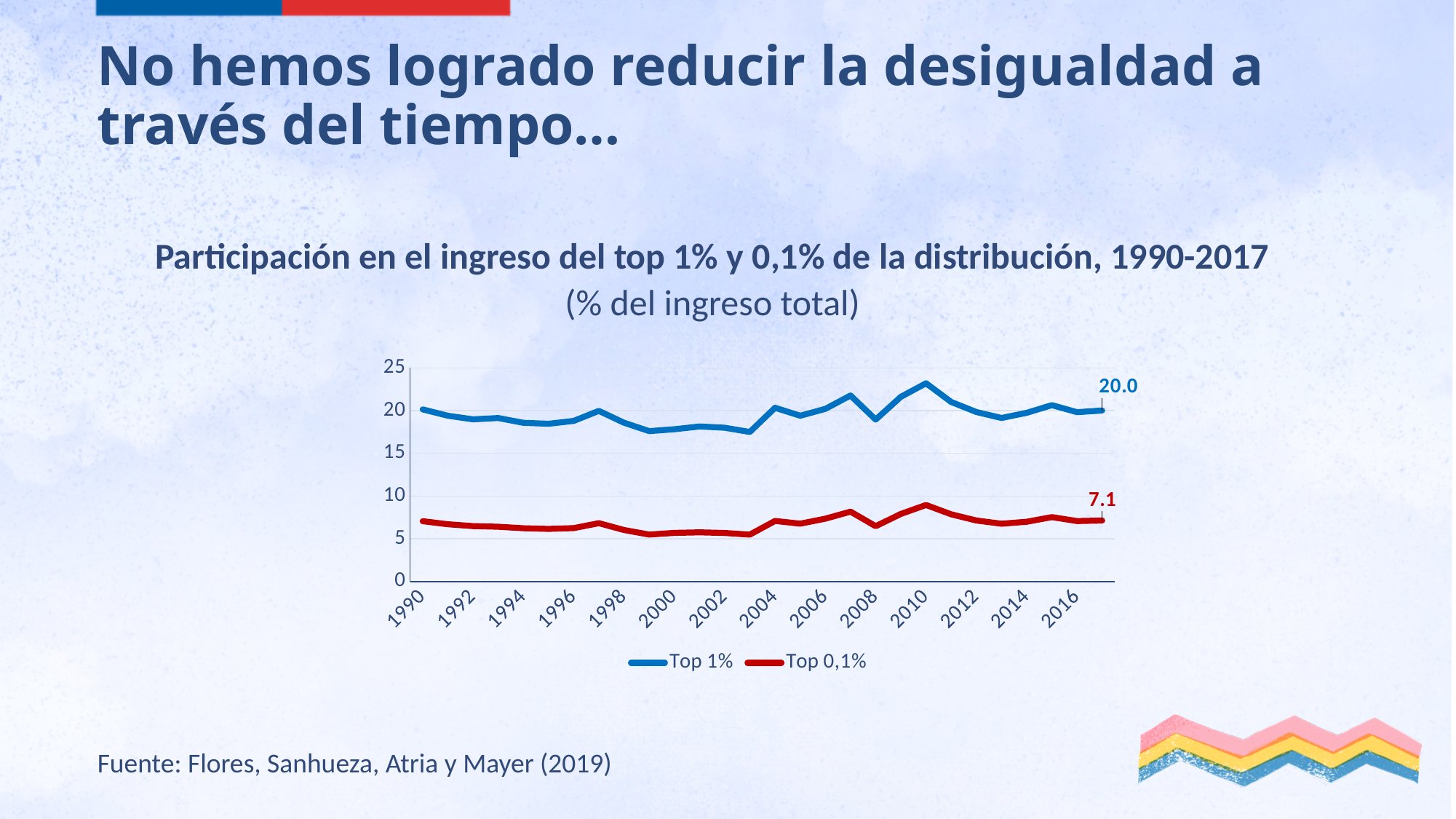
What is the difference between the final labelled values of the Top 1% and Top 0,1% series? 12.9 Is the value for Top 1% in 2010 greater or less than 20? greater In which year does the Top 1% series reach its highest value? 2010 How many series does the legend list? 2 What colour is the line for the Top 0,1% series? red What is the value of the Top 1% series at the end of the period (2017)? 20.0 Is the value for Top 1% in 2003 greater or less than 20? less Is the value for Top 0,1% in 2000 greater or less than 10? less What kind of chart is shown on the slide? line chart What is the title of the chart? Participación en el ingreso del top 1% y 0,1% de la distribución, 1990-2017 (% del ingreso total) Which series has the larger value at the end of the period, Top 1% or Top 0,1%? Top 1% What is the value of the Top 0,1% series at the end of the period (2017)? 7.1